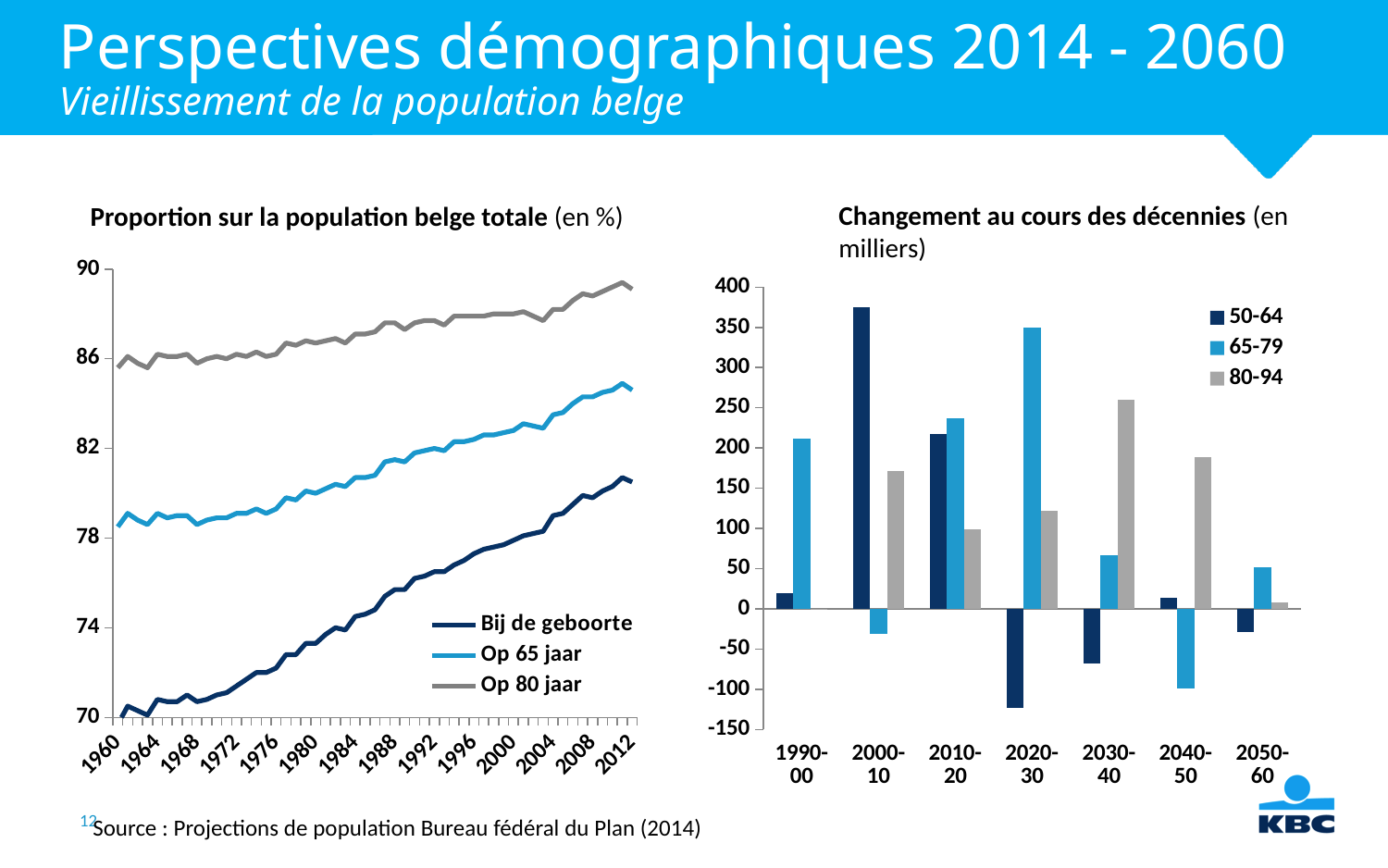
What kind of chart is the chart titled 'Changement au cours des décennies'? bar chart In the 'Proportion sur la population belge totale' chart, do the values of 'Bij de geboorte' rise or fall from 1960 to 2012? rise How many series does the legend of the 'Changement au cours des décennies' chart list? 3 In the 'Changement au cours des décennies' chart, which is larger in 2030-40: the 65-79 bar or the 80-94 bar? 80-94 How many series does the legend of the 'Proportion sur la population belge totale' chart list? 3 How many decade categories are shown on the x axis of the 'Changement au cours des décennies' chart? 7 In the 'Changement au cours des décennies' chart, is the value for 50-64 in 2000-10 greater or less than 350? greater In the 'Changement au cours des décennies' chart, is the value for 50-64 in 2020-30 greater or less than -100? less In the 'Proportion sur la population belge totale' chart, is the value for 'Op 65 jaar' in 2012 greater or less than 82? greater What kind of chart is the chart titled 'Proportion sur la population belge totale'? line chart In the 'Changement au cours des décennies' chart, which decade has the highest bar for the 50-64 series? 2000-10 In the 'Proportion sur la population belge totale' chart, which series has the highest values throughout the period? Op 80 jaar